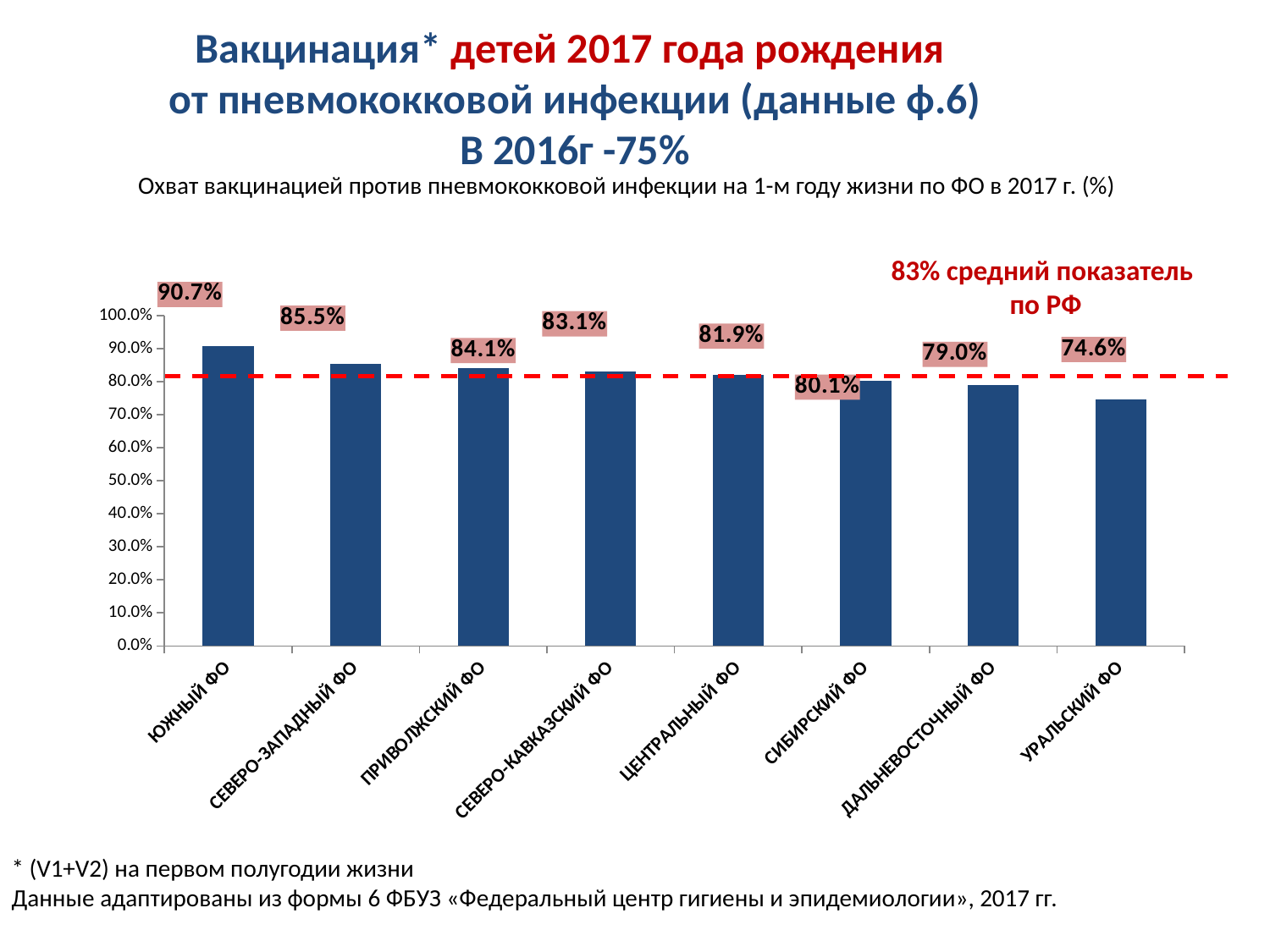
What is the difference between the values for ЮЖНЫЙ ФО and УРАЛЬСКИЙ ФО? 16.1% What is the value shown for УРАЛЬСКИЙ ФО? 74.6% What average value for the Russian Federation is indicated by the red dashed line? 83% How many federal districts are shown on the chart? 8 What kind of chart is shown on the slide? bar chart Which federal district has the lowest vaccination coverage on the chart? УРАЛЬСКИЙ ФО Do the bar values rise or fall from left to right along the x axis? fall What is the vaccination coverage value shown for ЮЖНЫЙ ФО? 90.7% What is the value shown for СИБИРСКИЙ ФО? 80.1% Which has a higher value, СЕВЕРО-ЗАПАДНЫЙ ФО or ДАЛЬНЕВОСТОЧНЫЙ ФО? СЕВЕРО-ЗАПАДНЫЙ ФО Is the value for ЦЕНТРАЛЬНЫЙ ФО greater or less than 90.0%? less Which federal district has the highest vaccination coverage on the chart? ЮЖНЫЙ ФО